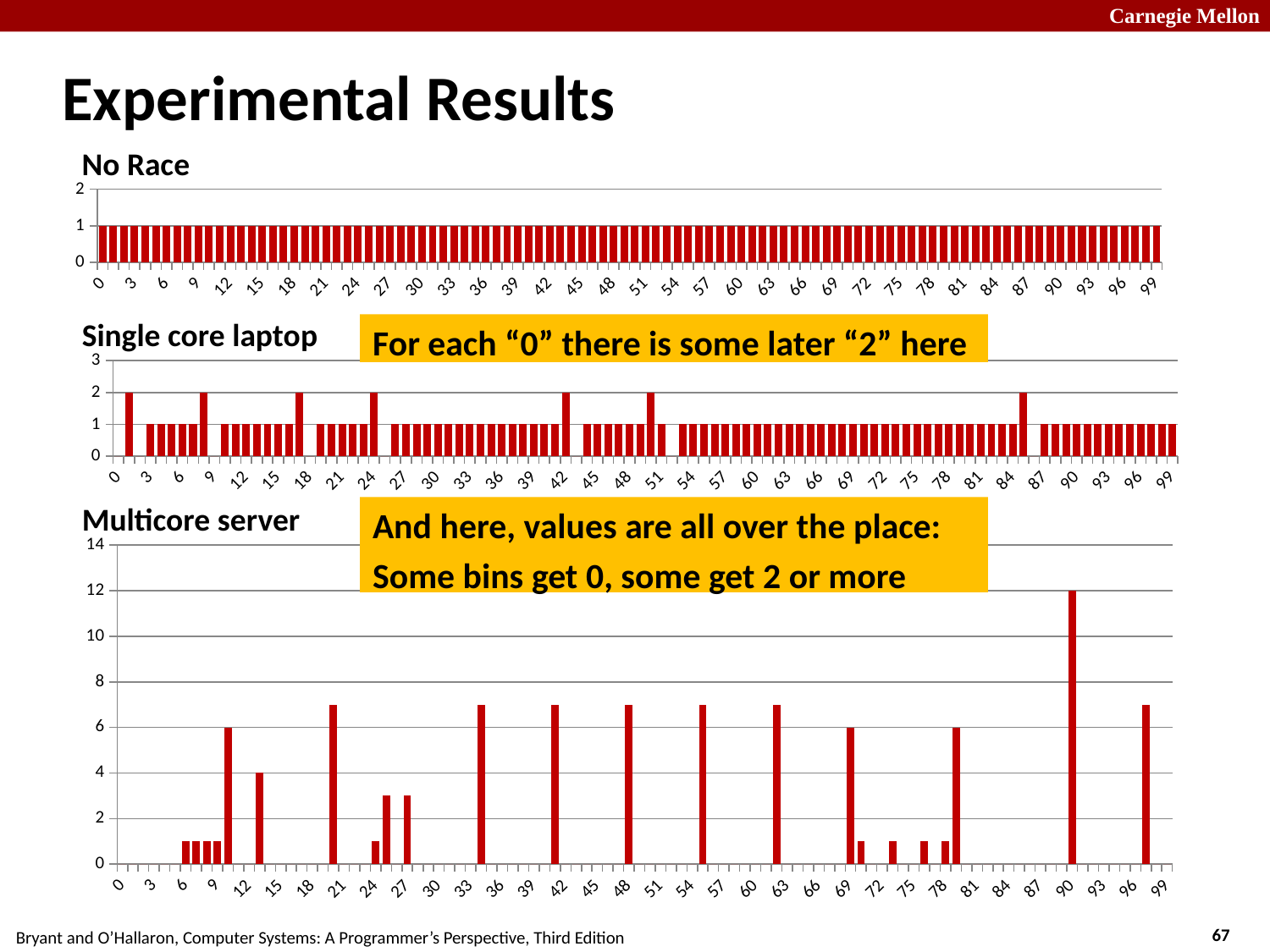
In the 'No Race' chart, do the values rise, fall, or stay flat along the x axis? stay flat In the 'Multicore server' chart, what is the value of the tallest bar? 12 In the 'No Race' chart, what is the value of the bar at x = 3? 1 How many charts are shown on the slide? 3 What kind of chart is the 'No Race' chart at the top of the slide? bar chart In the 'No Race' chart, is the value at x = 50 greater or less than 2? less What is the difference between the highest value in the 'Multicore server' chart and the highest value in the 'Single core laptop' chart? 10 In the 'Single core laptop' chart, is the value at x = 30 greater or less than 2? less In the 'Multicore server' chart, is the value at x = 90 greater or less than 10? greater In the 'Multicore server' chart, at which x-axis position is the tallest bar? 90 What is the highest tick shown on the y axis of the 'Multicore server' chart? 14 In the 'Single core laptop' chart, what is the highest value reached by any bar? 2